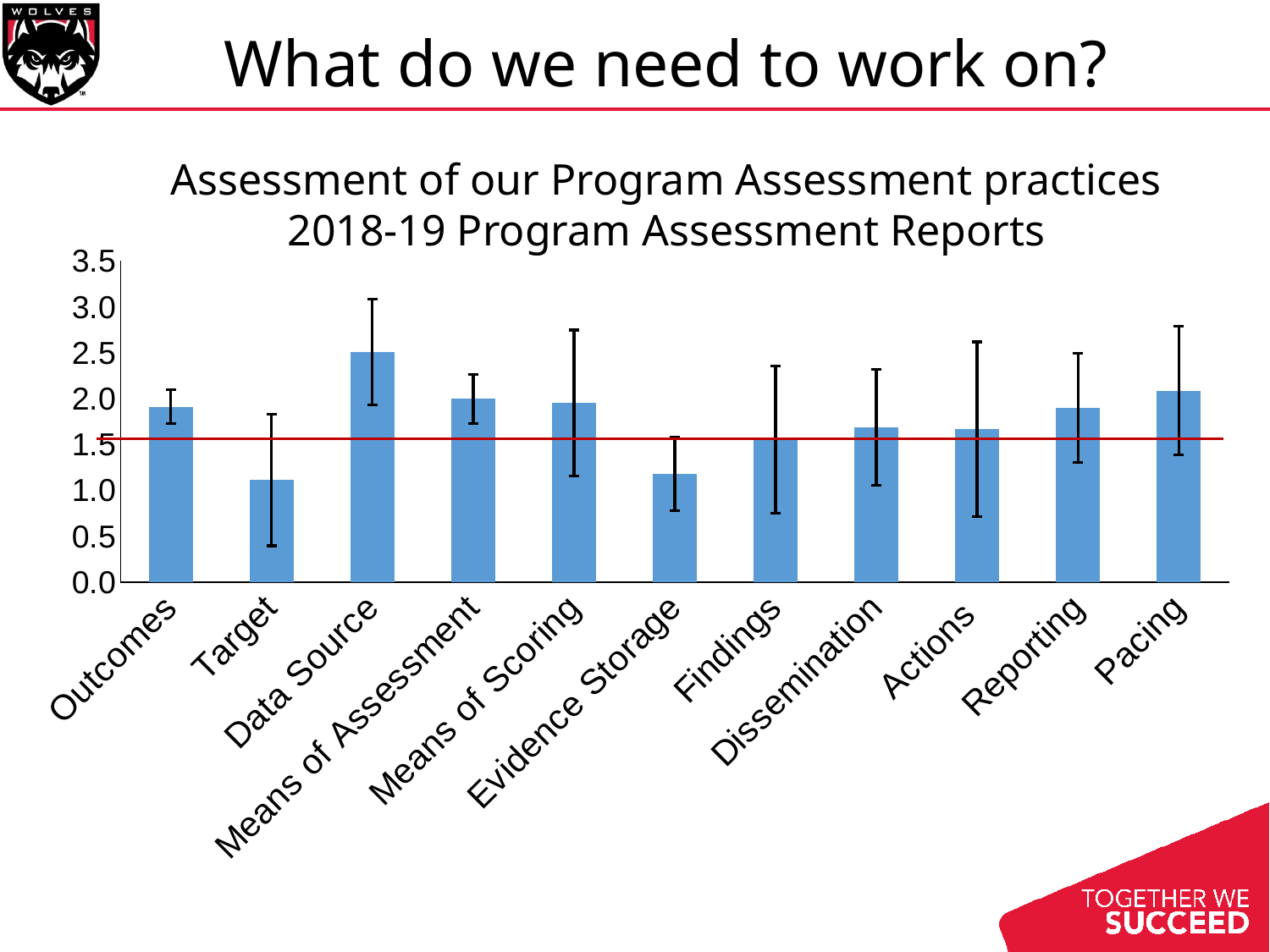
Is the value for Evidence Storage greater or less than 1.5? less Which is larger, the value for Outcomes or the value for Evidence Storage? Outcomes How many categories are plotted along the x axis of the chart? 11 Which is larger, the value for Pacing or the value for Findings? Pacing Is the value for Data Source greater or less than 2.0? greater What kind of chart is shown on the slide? bar chart Is the value for Outcomes greater or less than 1.5? greater Which is larger, the value for Data Source or the value for Target? Data Source Which category has the highest bar in the chart? Data Source What is the title of the chart? Assessment of our Program Assessment practices 2018-19 Program Assessment Reports